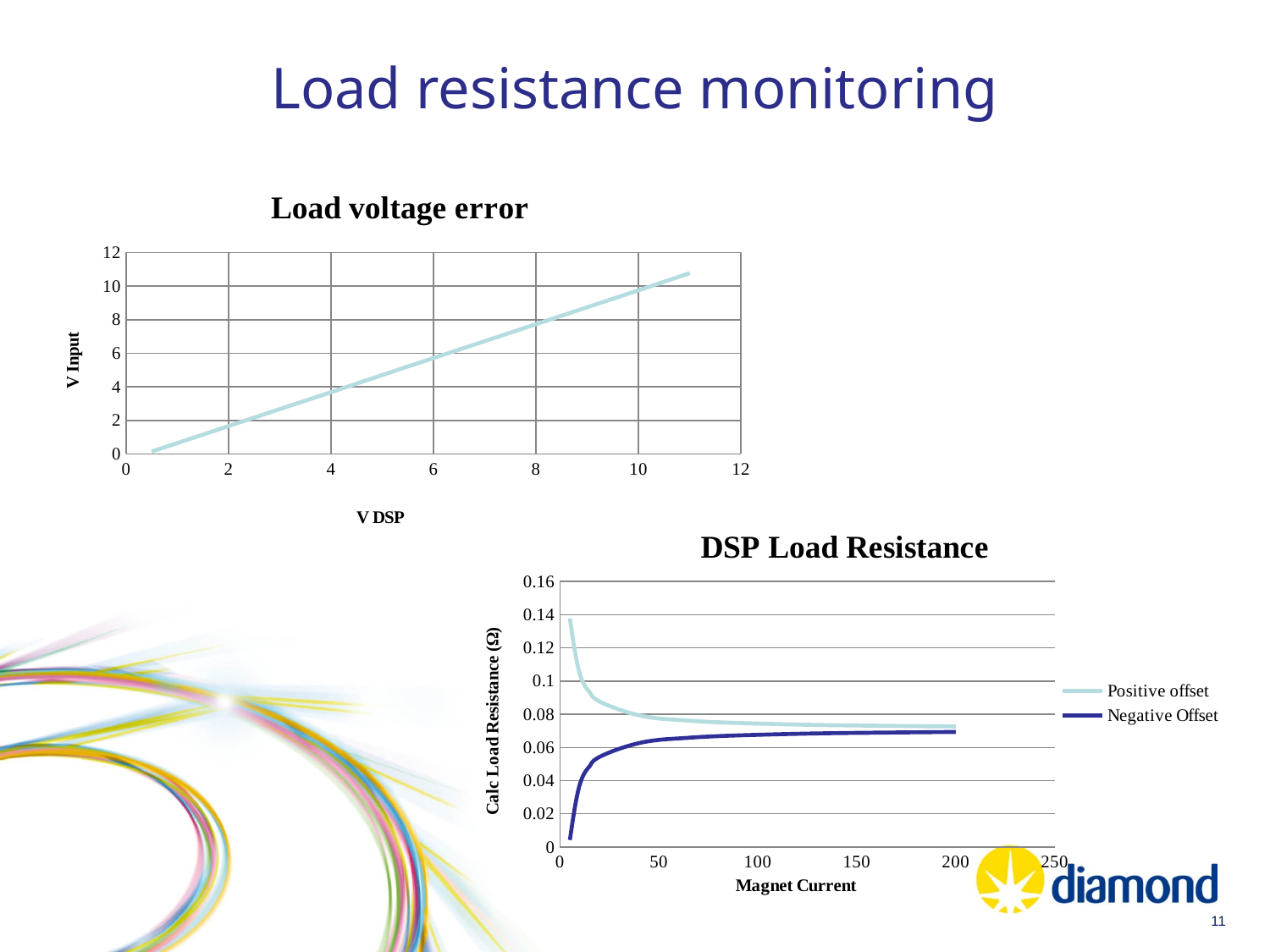
In the 'DSP Load Resistance' chart, is the Negative Offset value at a Magnet Current of 200 greater or less than 0.06? greater What kind of chart is the 'Load voltage error' chart? line chart In the 'Load voltage error' chart, does V Input rise or fall as V DSP increases? rise In the 'DSP Load Resistance' chart, does the Negative Offset series rise or fall as Magnet Current increases? rise In the 'DSP Load Resistance' chart, does the Positive offset series rise or fall as Magnet Current increases? fall What is the x-axis label of the 'Load voltage error' chart? V DSP How many series does the legend of the 'DSP Load Resistance' chart list? 2 In the 'DSP Load Resistance' chart, is the Positive offset value at a Magnet Current of 200 greater or less than 0.08? less In the 'DSP Load Resistance' chart, at a Magnet Current of 50, which series has the higher value, Positive offset or Negative Offset? Positive offset What is the y-axis label of the 'DSP Load Resistance' chart? Calc Load Resistance (Ω) In the 'Load voltage error' chart, is the V Input value at a V DSP of 4 greater or less than 6? less What kind of chart is the 'DSP Load Resistance' chart? line chart